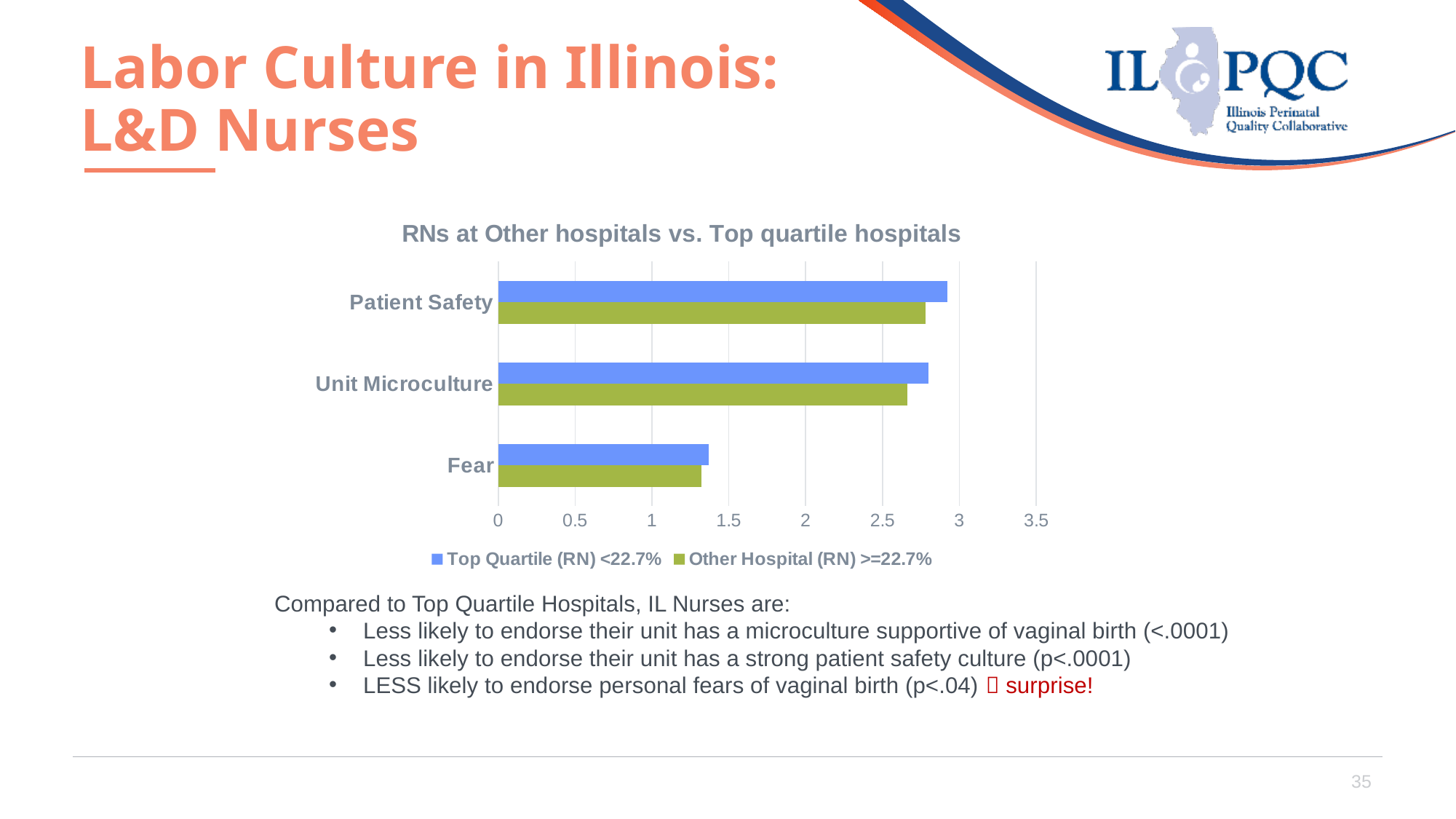
Is the Top Quartile (RN) <22.7% value for Fear greater or less than 1.5? less For Patient Safety, which series has the larger value: Top Quartile (RN) <22.7% or Other Hospital (RN) >=22.7%? Top Quartile (RN) <22.7% What is the title of the chart? RNs at Other hospitals vs. Top quartile hospitals How many series does the chart legend list? 2 For Unit Microculture, which series has the larger value: Top Quartile (RN) <22.7% or Other Hospital (RN) >=22.7%? Top Quartile (RN) <22.7% How many categories are shown on the chart? 3 Is the Top Quartile (RN) <22.7% value for Patient Safety greater or less than 2.5? greater What kind of chart is shown on the slide? Bar chart Which category has the lowest value for the Top Quartile (RN) <22.7% series? Fear Which colour represents the Other Hospital (RN) >=22.7% series? Green Which category has the lowest value for the Other Hospital (RN) >=22.7% series? Fear Is the Other Hospital (RN) >=22.7% value for Unit Microculture greater or less than 2.5? greater